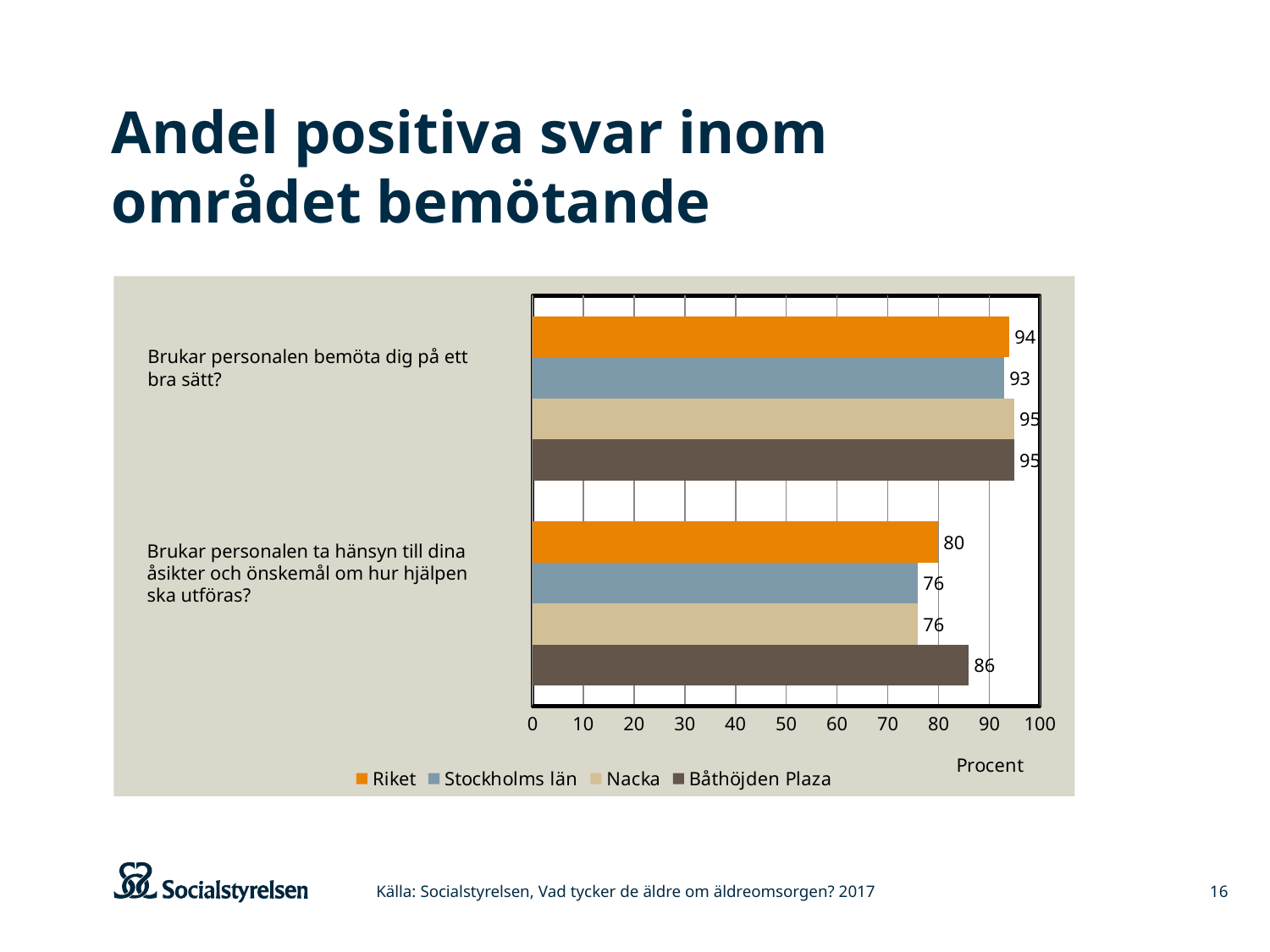
Which is larger on the question "Brukar personalen ta hänsyn till dina åsikter och önskemål om hur hjälpen ska utföras?": the value for Riket or the value for Nacka? Riket What is the value for Riket on the question "Brukar personalen bemöta dig på ett bra sätt?"? 94 What is the value for Båthöjden Plaza on the question "Brukar personalen ta hänsyn till dina åsikter och önskemål om hur hjälpen ska utföras?"? 86 What kind of chart is shown on the slide? Bar chart What is the difference between the Båthöjden Plaza value and the Riket value on the question "Brukar personalen ta hänsyn till dina åsikter och önskemål om hur hjälpen ska utföras?"? 6 What is the value for Stockholms län on the question "Brukar personalen ta hänsyn till dina åsikter och önskemål om hur hjälpen ska utföras?"? 76 How many questions (categories) are shown on the chart? 2 Which series has the highest value on the question "Brukar personalen ta hänsyn till dina åsikter och önskemål om hur hjälpen ska utföras?"? Båthöjden Plaza Is the value for Nacka on the question "Brukar personalen bemöta dig på ett bra sätt?" greater or less than 90? greater Which series has the lowest value on the question "Brukar personalen bemöta dig på ett bra sätt?"? Stockholms län How many series does the legend list? 4 What unit is shown on the horizontal axis of the chart? Procent